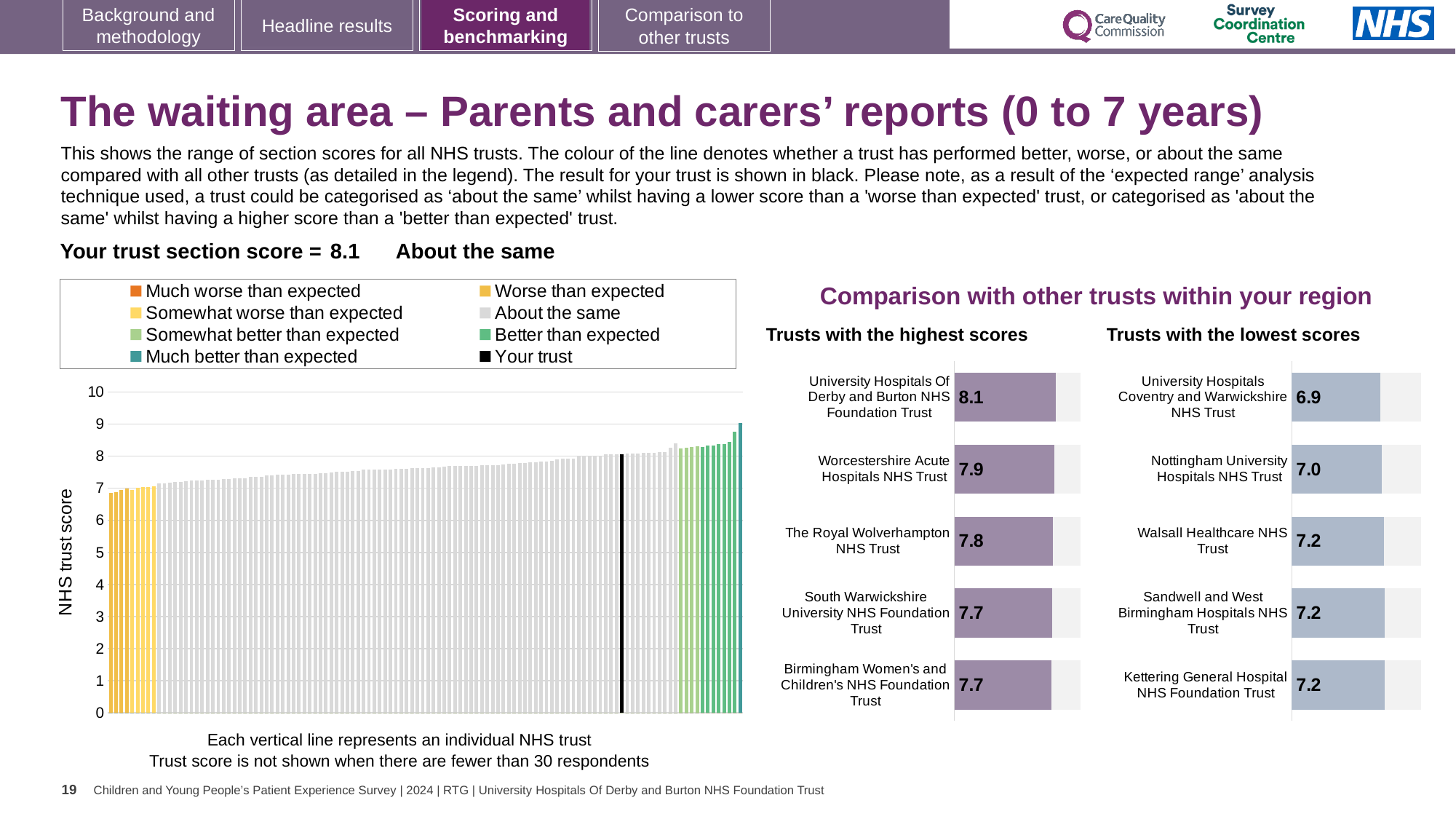
How many trusts are shown in the 'Trusts with the lowest scores' chart? 5 In the 'Trusts with the lowest scores' chart, what is the difference between the scores of Walsall Healthcare NHS Trust and University Hospitals Coventry and Warwickshire NHS Trust? 0.3 In the 'Trusts with the lowest scores' chart, what is the score for Nottingham University Hospitals NHS Trust? 7.0 In the 'Trusts with the highest scores' chart, which trust has the highest score? University Hospitals Of Derby and Burton NHS Foundation Trust In the 'Trusts with the lowest scores' chart, which trust has the lowest score? University Hospitals Coventry and Warwickshire NHS Trust In the 'Trusts with the highest scores' chart, which has the larger score: Worcestershire Acute Hospitals NHS Trust or The Royal Wolverhampton NHS Trust? Worcestershire Acute Hospitals NHS Trust In the large chart on the left, do the trust scores rise or fall from left to right? Rise In the 'Trusts with the highest scores' chart, what is the score for The Royal Wolverhampton NHS Trust? 7.8 What kind of chart is the large chart on the left with the y-axis labelled 'NHS trust score'? Bar chart In the 'Trusts with the highest scores' chart, what is the difference between the scores of University Hospitals Of Derby and Burton NHS Foundation Trust and The Royal Wolverhampton NHS Trust? 0.3 How many entries does the legend above the large chart on the left list? 8 In the 'Trusts with the highest scores' chart, what is the score for University Hospitals Of Derby and Burton NHS Foundation Trust? 8.1